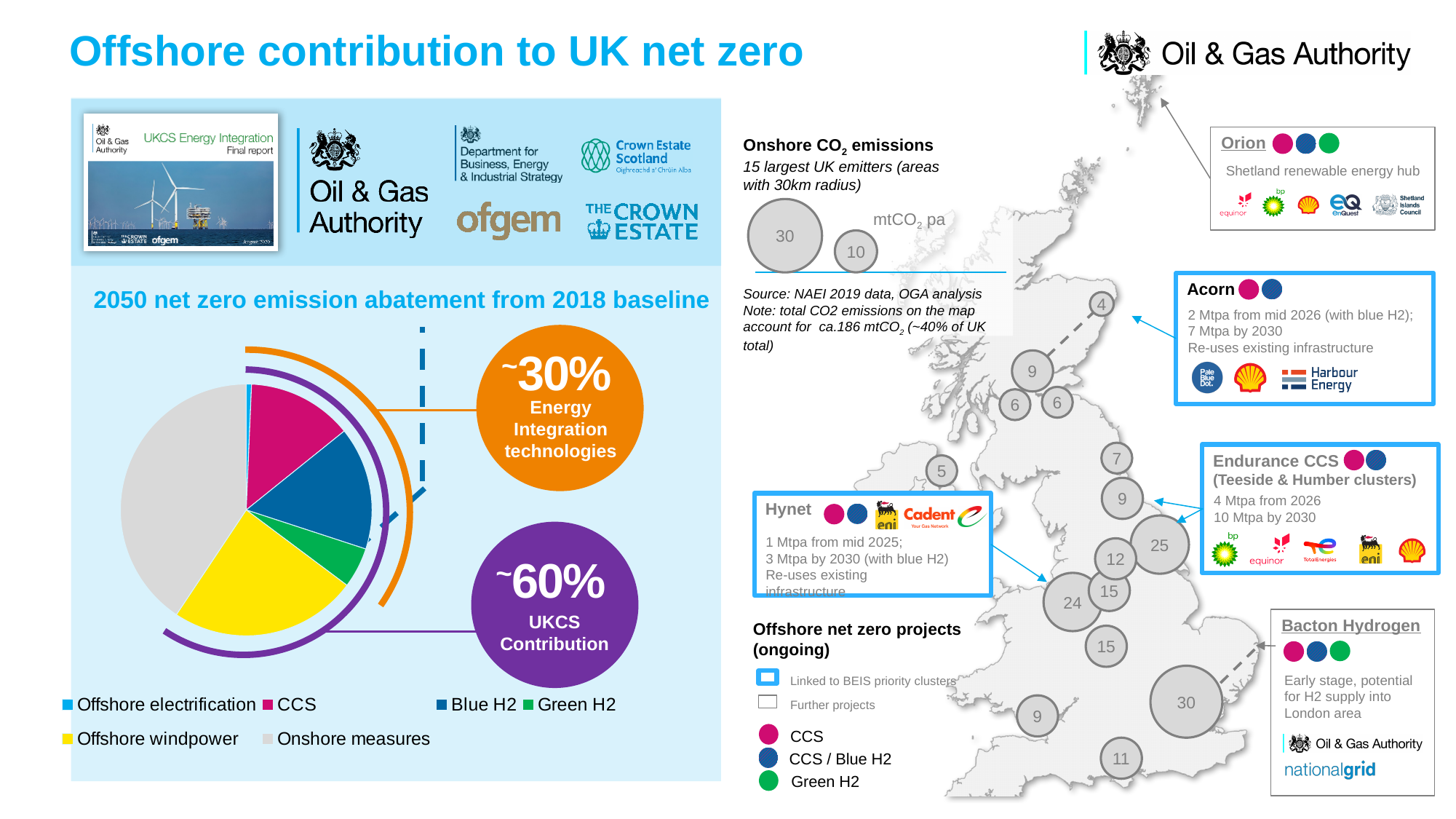
In the pie chart, which slice is larger: Offshore windpower or CCS? Offshore windpower In the pie chart, which slice is larger: Blue H2 or Green H2? Blue H2 Which category has the largest slice in the pie chart? Onshore measures What kind of chart is used to show the 2050 net zero emission abatement from 2018 baseline? Pie chart What colour represents Offshore windpower in the pie chart? Yellow In the pie chart, which slice is larger: CCS or Green H2? CCS What is the title of the pie chart on the left of the slide? 2050 net zero emission abatement from 2018 baseline How many categories does the legend of the pie chart list? 6 Which category has the smallest slice in the pie chart? Offshore electrification